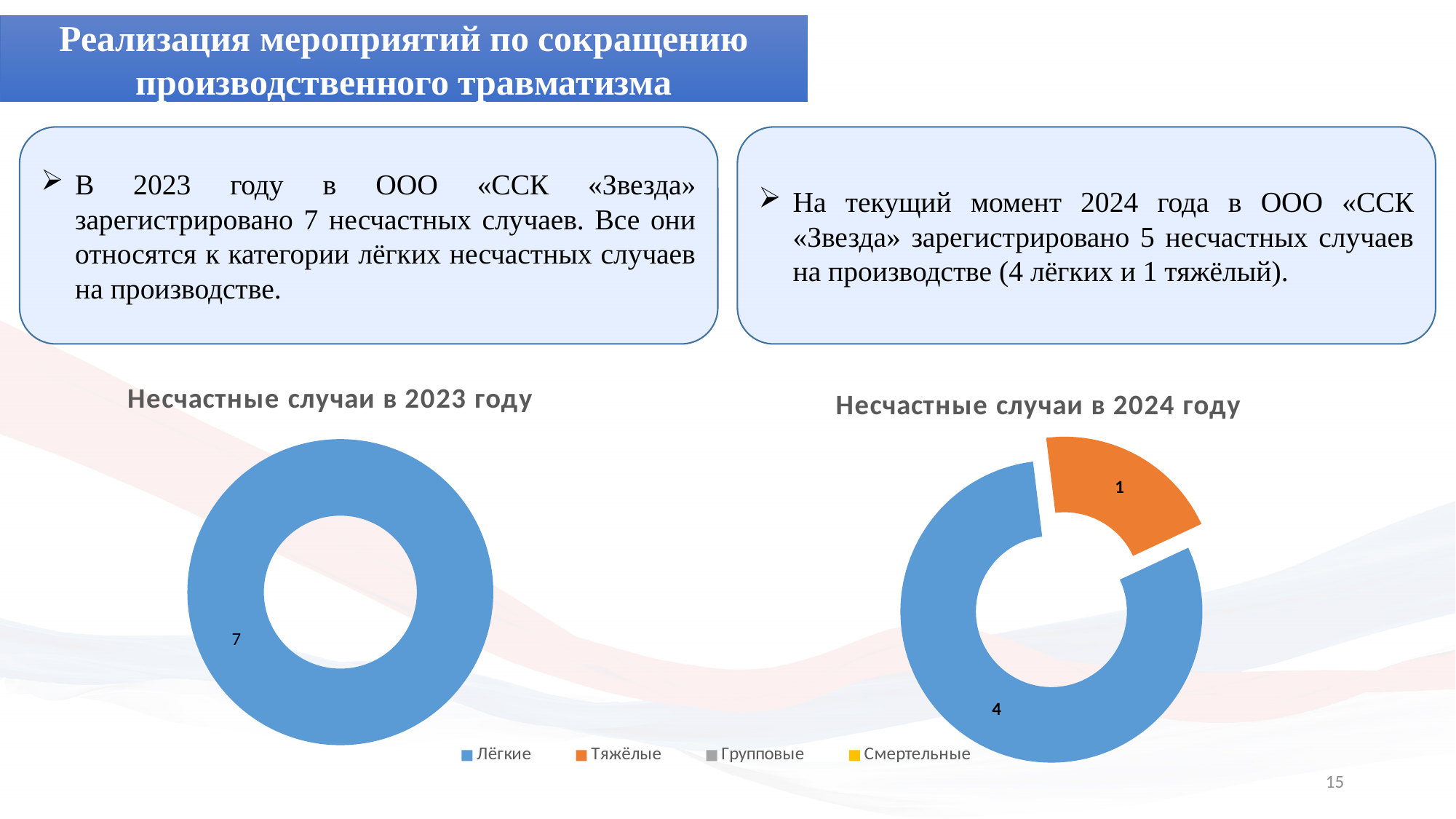
In the chart 'Несчастные случаи в 2023 году', what is the value for Лёгкие? 7 In the chart 'Несчастные случаи в 2024 году', what is the total of all slices? 5 How many entries does the shared legend below the charts list? 4 In the chart 'Несчастные случаи в 2024 году', what colour is the Тяжёлые slice? Orange In the chart 'Несчастные случаи в 2024 году', what is the difference between the Лёгкие and Тяжёлые values? 3 In the chart 'Несчастные случаи в 2024 году', which category has the smallest slice? Тяжёлые In the chart 'Несчастные случаи в 2024 году', which is larger, Лёгкие or Тяжёлые? Лёгкие In the chart 'Несчастные случаи в 2024 году', what is the value for Лёгкие? 4 What kind of chart is 'Несчастные случаи в 2023 году'? Doughnut (pie) chart In the chart 'Несчастные случаи в 2024 году', what share of the total does the Тяжёлые slice represent? 20% In the chart 'Несчастные случаи в 2024 году', what is the value for Тяжёлые? 1 In the chart 'Несчастные случаи в 2024 году', which category has the largest slice? Лёгкие